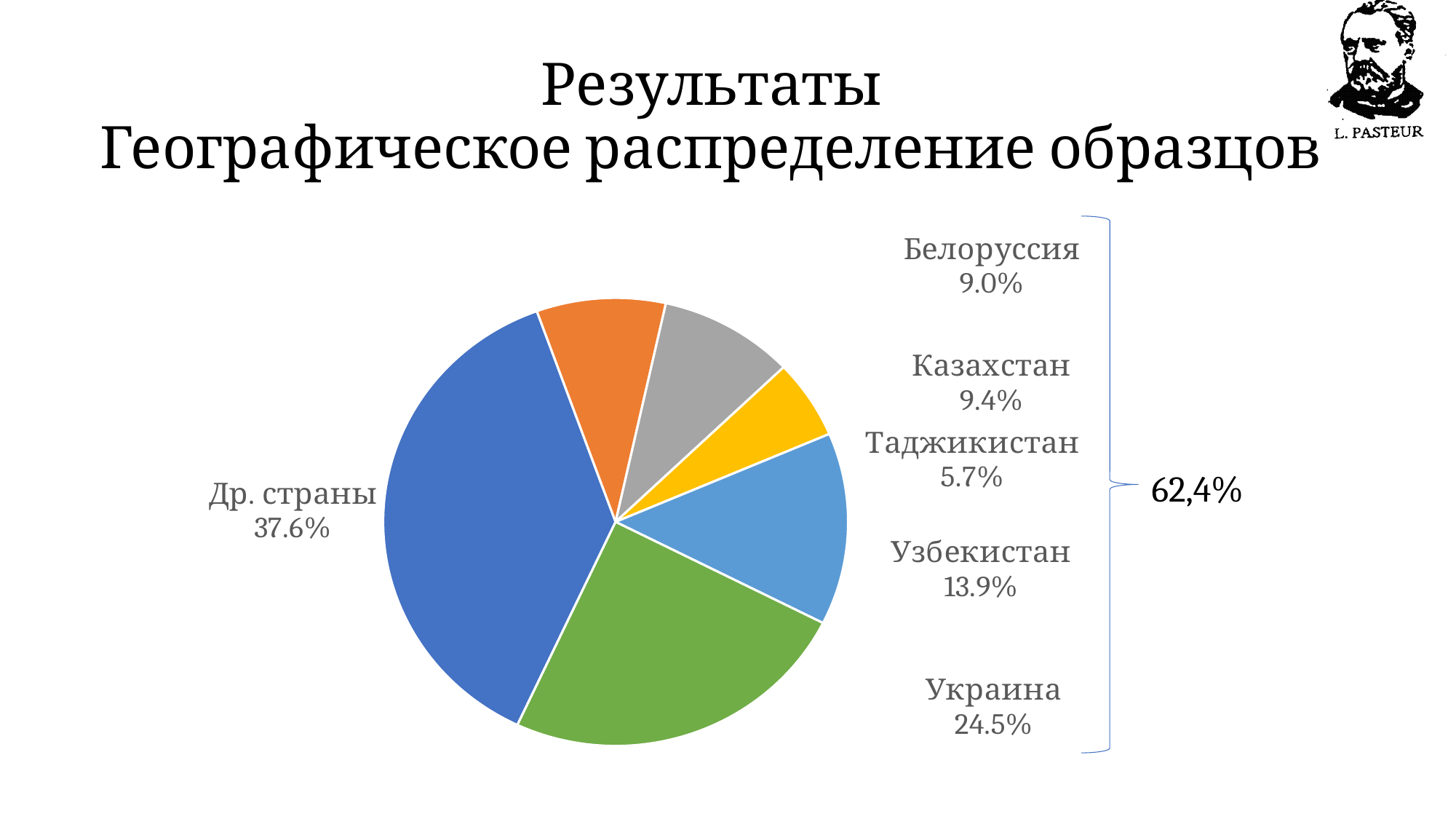
Which has a larger share, Узбекистан or Белоруссия? Узбекистан What share of the pie does Украина have? 24.5% What share of the pie does Узбекистан have? 13.9% What is the difference between the shares of Казахстан and Белоруссия? 0.4% What is the value shown for Казахстан? 9.4% What combined percentage is shown by the bracket next to the five named countries? 62,4% What kind of chart is shown on the slide? pie chart How many slices does the pie chart have? 6 Which category has the smallest slice of the pie? Таджикистан What is the value shown for Таджикистан? 5.7% Which category has the largest slice of the pie? Др. страны What is the difference between the shares of Др. страны and Украина? 13.1%